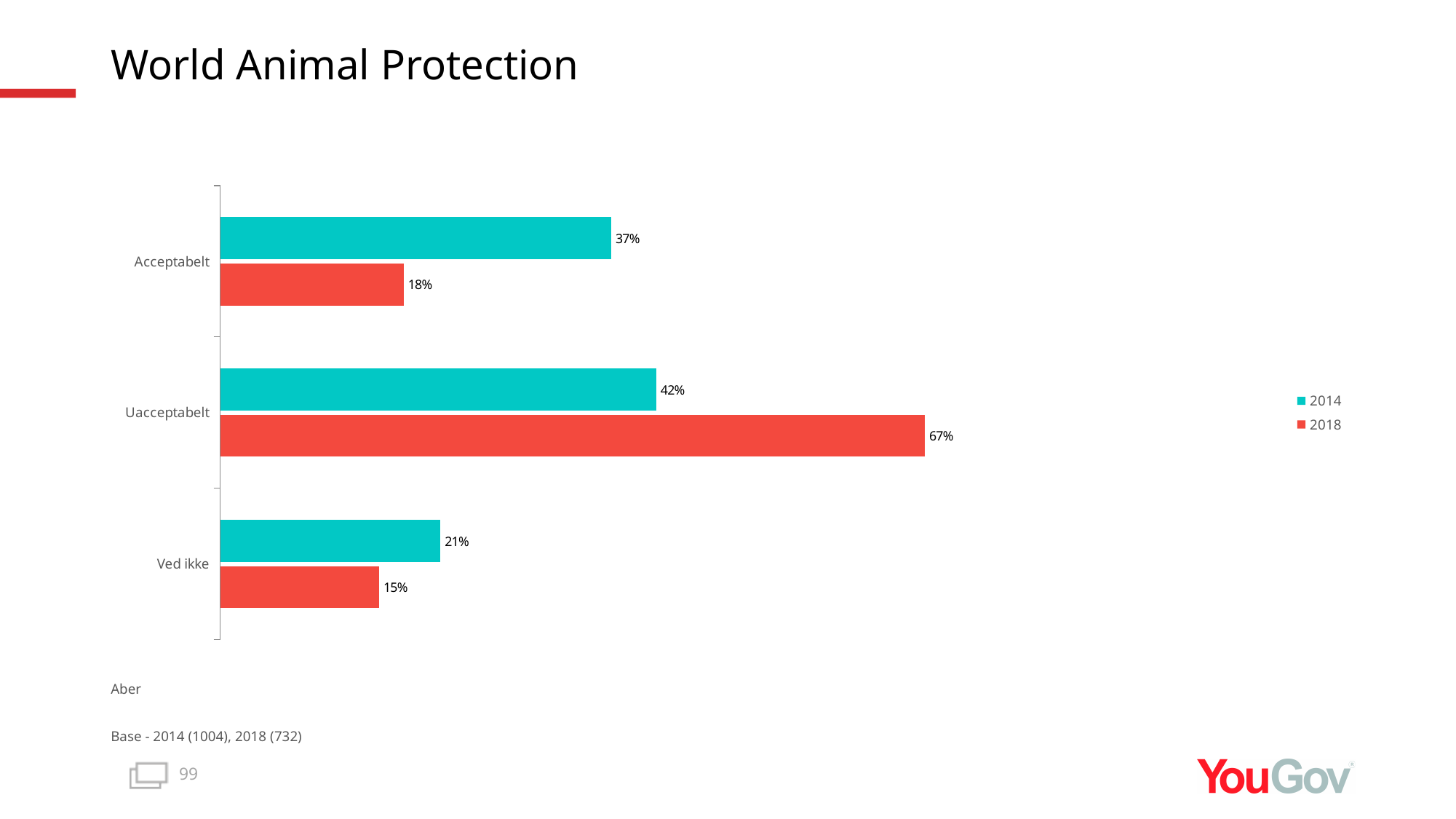
Which category has the highest 2018 value? Uacceptabelt How many series does the legend list? 2 What is the difference between the 2018 and 2014 values for Uacceptabelt? 25% What is the 2014 value for Ved ikke? 21% What kind of chart is shown on the slide? Bar chart Which is larger for Acceptabelt, the 2014 value or the 2018 value? 2014 What is the 2014 value for Acceptabelt? 37% What is the 2018 value for Ved ikke? 15% What is the 2018 value for Uacceptabelt? 67% What is the difference between the 2014 and 2018 values for Acceptabelt? 19% How many categories are shown on the chart? 3 Which category has the lowest 2014 value? Ved ikke